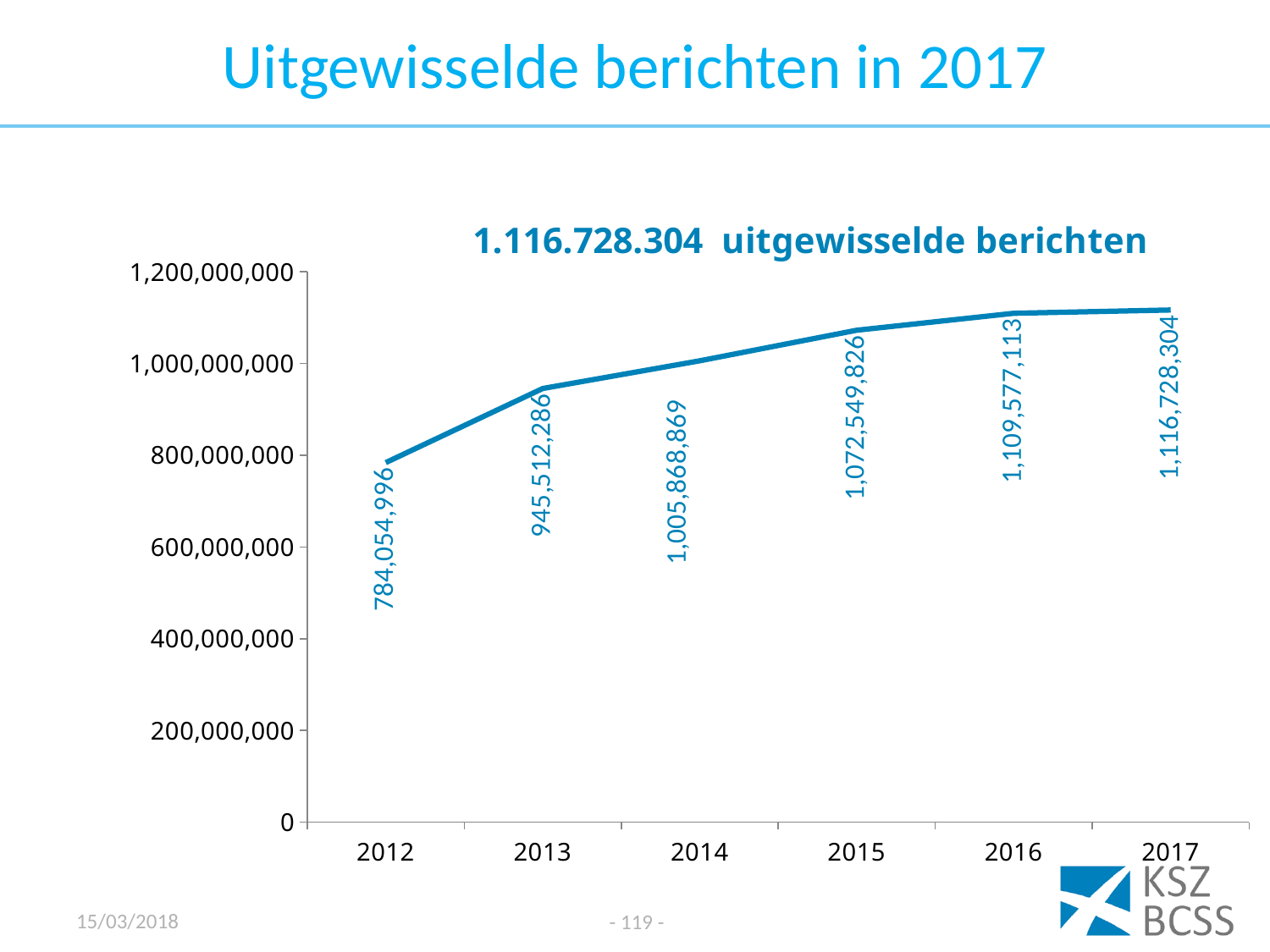
What is the difference between the values for 2013 and 2012? 161,457,290 What is the value for 2014? 1,005,868,869 What is the value for 2012? 784,054,996 Which year has the lowest value? 2012 What is the value for 2016? 1,109,577,113 What is the value for 2017? 1,116,728,304 How many years are plotted on the x axis? 6 Which year has the highest value? 2017 Which is larger, the value for 2015 or the value for 2014? 2015 What is the difference between the values for 2017 and 2016? 7,151,191 Do the values rise or fall from 2012 to 2017? rise What kind of chart is shown on the slide? line chart